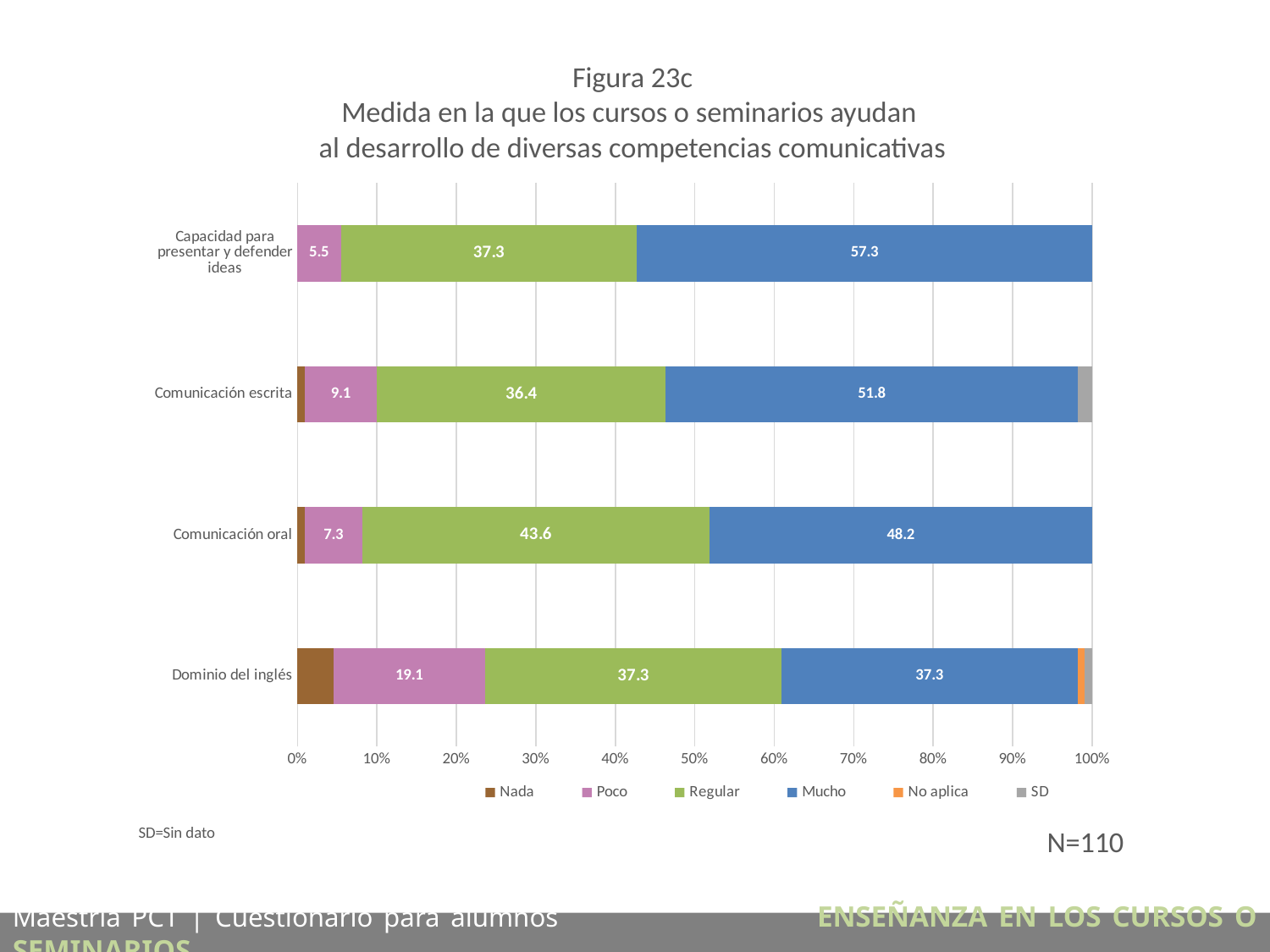
Which category has the highest Poco value? Dominio del inglés Is the Nada segment for Dominio del inglés greater or less than 10%? less What is the value of the Regular segment for Comunicación oral? 43.6 What kind of chart is shown on the slide? Stacked bar chart For Comunicación oral, which is larger: the Regular segment or the Mucho segment? Mucho Which category has the highest Mucho value? Capacidad para presentar y defender ideas How many series does the legend list? 6 What is the value of the Poco segment for Dominio del inglés? 19.1 How many categories are shown on the chart? 4 Which category has the lowest Mucho value? Dominio del inglés What is the value of the Mucho segment for Capacidad para presentar y defender ideas? 57.3 For Comunicación escrita, what is the difference between the Mucho and Regular values? 15.4